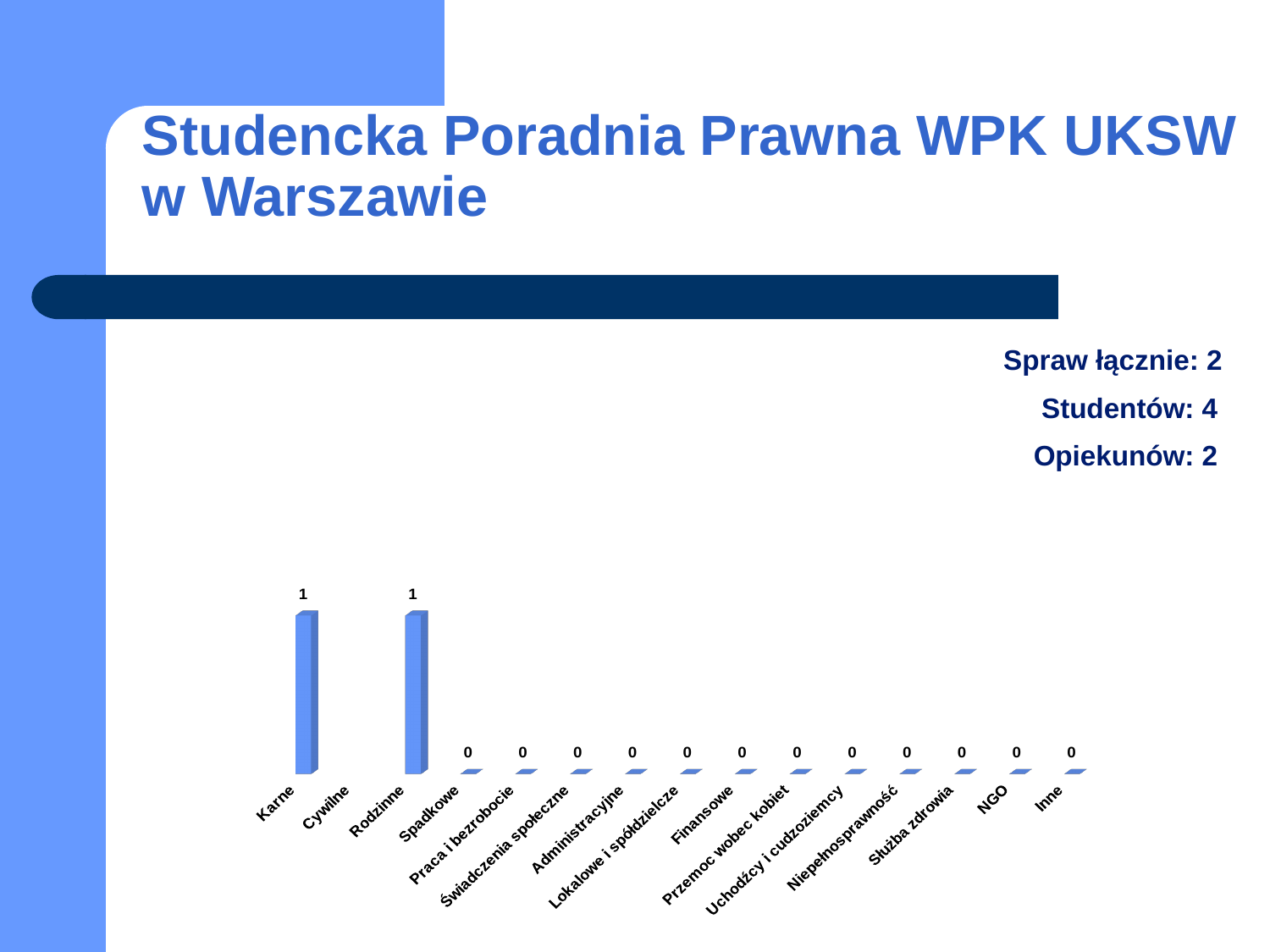
How many categories are shown on the x axis? 15 What is the value for Spadkowe? 0 What is the value for Karne? 1 What is the first category on the x axis? Karne What is the value for Finansowe? 0 Which categories have a value of 1? Karne and Rodzinne What kind of chart is shown on the slide? Bar chart Which is larger, the value for Rodzinne or the value for Administracyjne? Rodzinne What is the difference between the values for Karne and Spadkowe? 1 What is the value for Rodzinne? 1 What is the value for Inne? 0 What is the value for NGO? 0